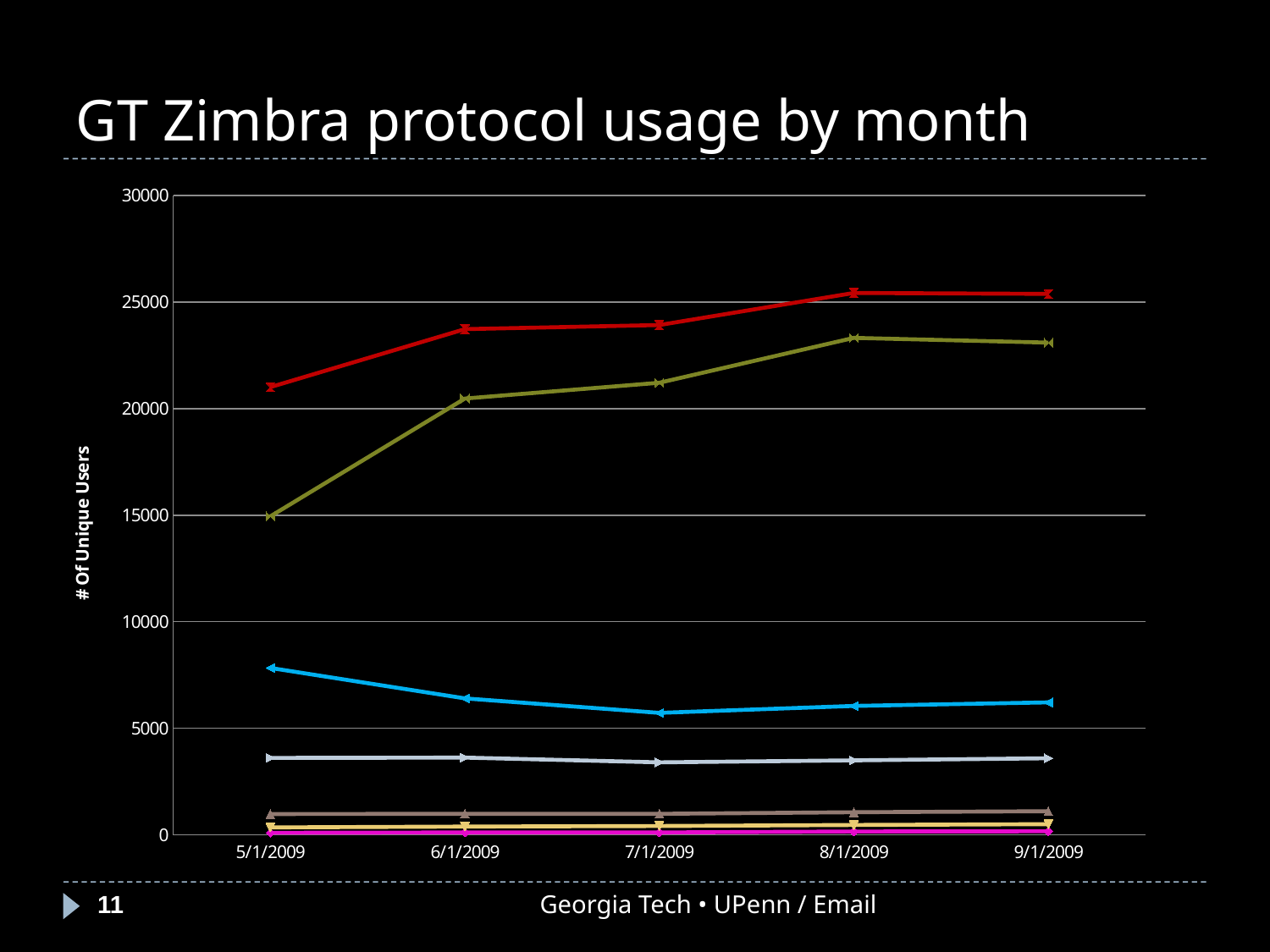
What kind of chart is shown on the slide? line chart How many dates are shown along the x axis of the chart? 5 On which date does the olive green line have its lowest value? 5/1/2009 Is the value of the olive green line at 8/1/2009 greater or less than 20000? greater What is the title of the slide containing the chart? GT Zimbra protocol usage by month What is the label of the vertical axis of the chart? # Of Unique Users At 5/1/2009, which line has the larger value, the red line or the olive green line? red line Does the olive green line rise or fall between 5/1/2009 and 8/1/2009? rise Does the light blue line rise or fall between 5/1/2009 and 7/1/2009? fall Is the value of the light blue line at 7/1/2009 greater or less than 10000? less Is the value of the red line at 5/1/2009 greater or less than 20000? greater